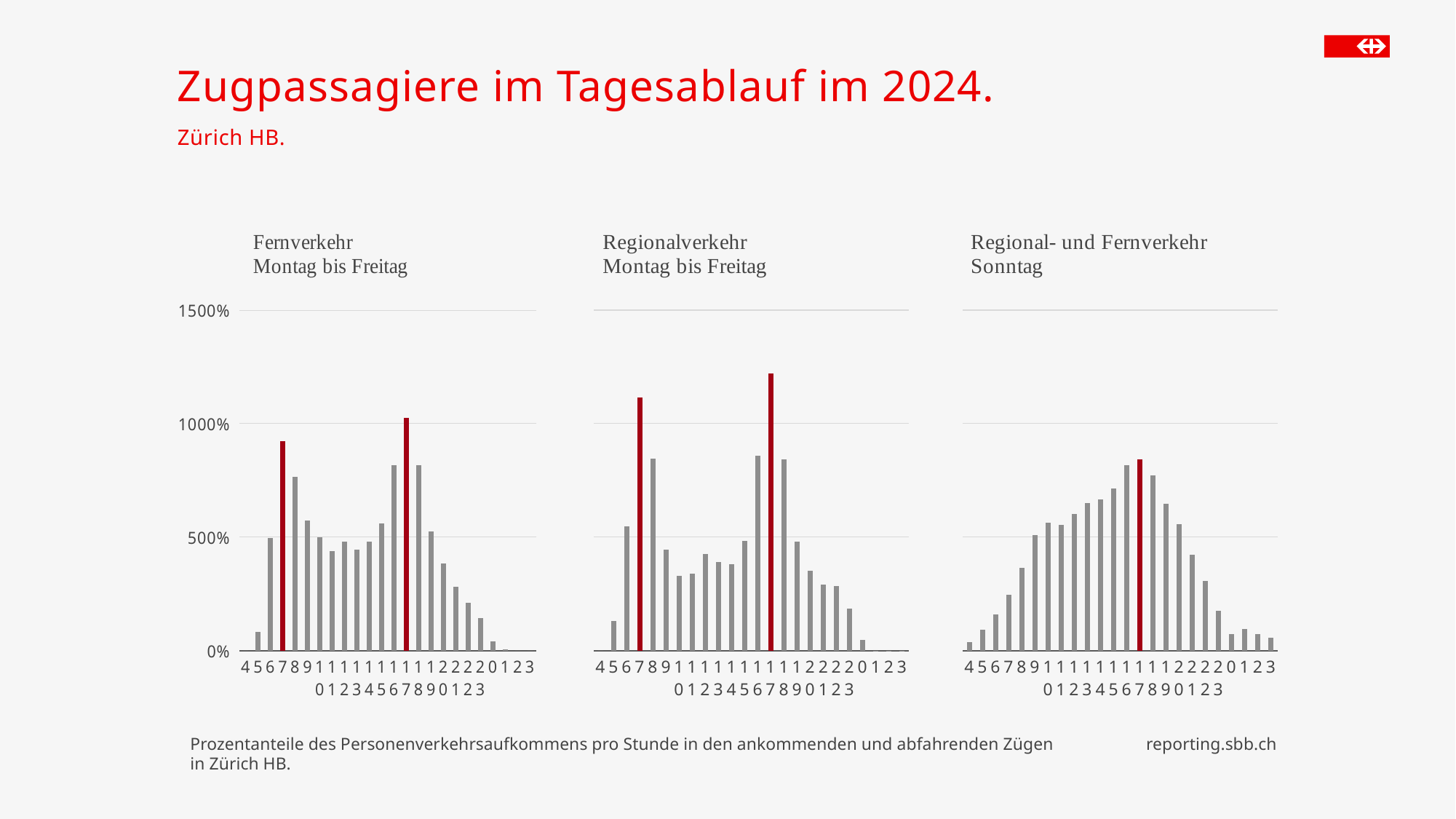
In the 'Fernverkehr Montag bis Freitag' chart, is the value for hour 7 greater or less than 500%? greater In the 'Regional- und Fernverkehr Sonntag' chart, is the value for hour 17 greater or less than 1000%? less How many hourly categories does the 'Regionalverkehr Montag bis Freitag' chart show on its x axis? 24 In the 'Regional- und Fernverkehr Sonntag' chart, is the value for hour 4 greater or less than 500%? less In the 'Fernverkehr Montag bis Freitag' chart, which hour has the highest value? 17 What kind of chart is the 'Fernverkehr Montag bis Freitag' chart? bar chart In the 'Regionalverkehr Montag bis Freitag' chart, which hour has the highest value? 17 In the 'Regionalverkehr Montag bis Freitag' chart, which is larger, the value for hour 7 or the value for hour 8? hour 7 How many bar charts are shown on the slide? 3 In the 'Fernverkehr Montag bis Freitag' chart, which is larger, the value for hour 8 or the value for hour 9? hour 8 What is the title of the slide? Zugpassagiere im Tagesablauf im 2024.